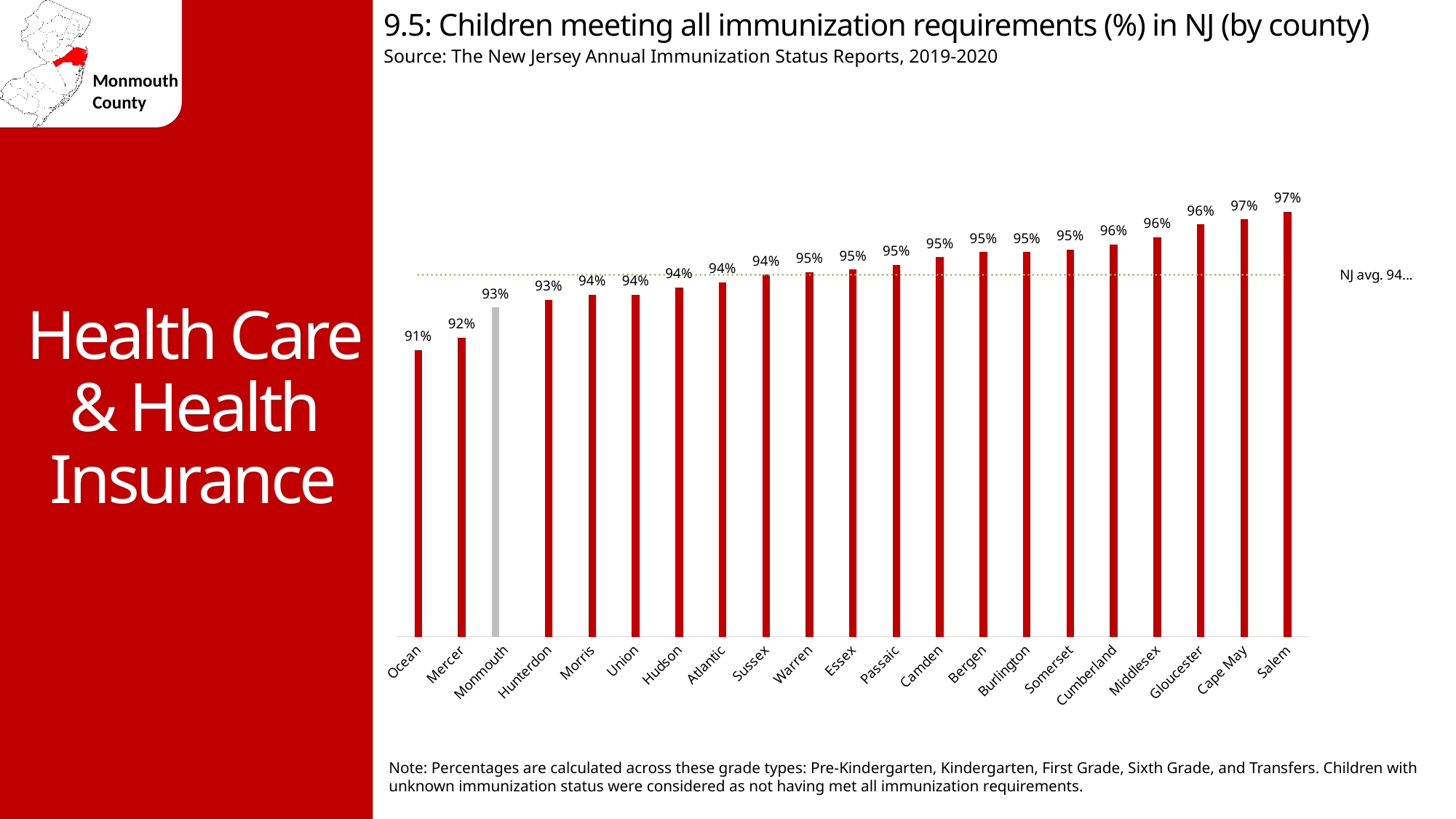
What is the value shown for Cumberland County? 96% What is the value shown for Salem County? 97% What is the difference in percentage points between Monmouth and Ocean? 2 percentage points Do the values rise or fall moving from left to right along the x axis? Rise How many counties are shown on the chart? 21 What percentage of children in Monmouth County met all immunization requirements? 93% What is the value shown for Ocean County? 91% Which county's bar is coloured grey instead of red? Monmouth Which has a higher value, Mercer or Cumberland? Cumberland Which county has the lowest percentage of children meeting all immunization requirements? Ocean What kind of chart is shown on the slide? Bar chart What is the difference in percentage points between Salem and Ocean? 6 percentage points